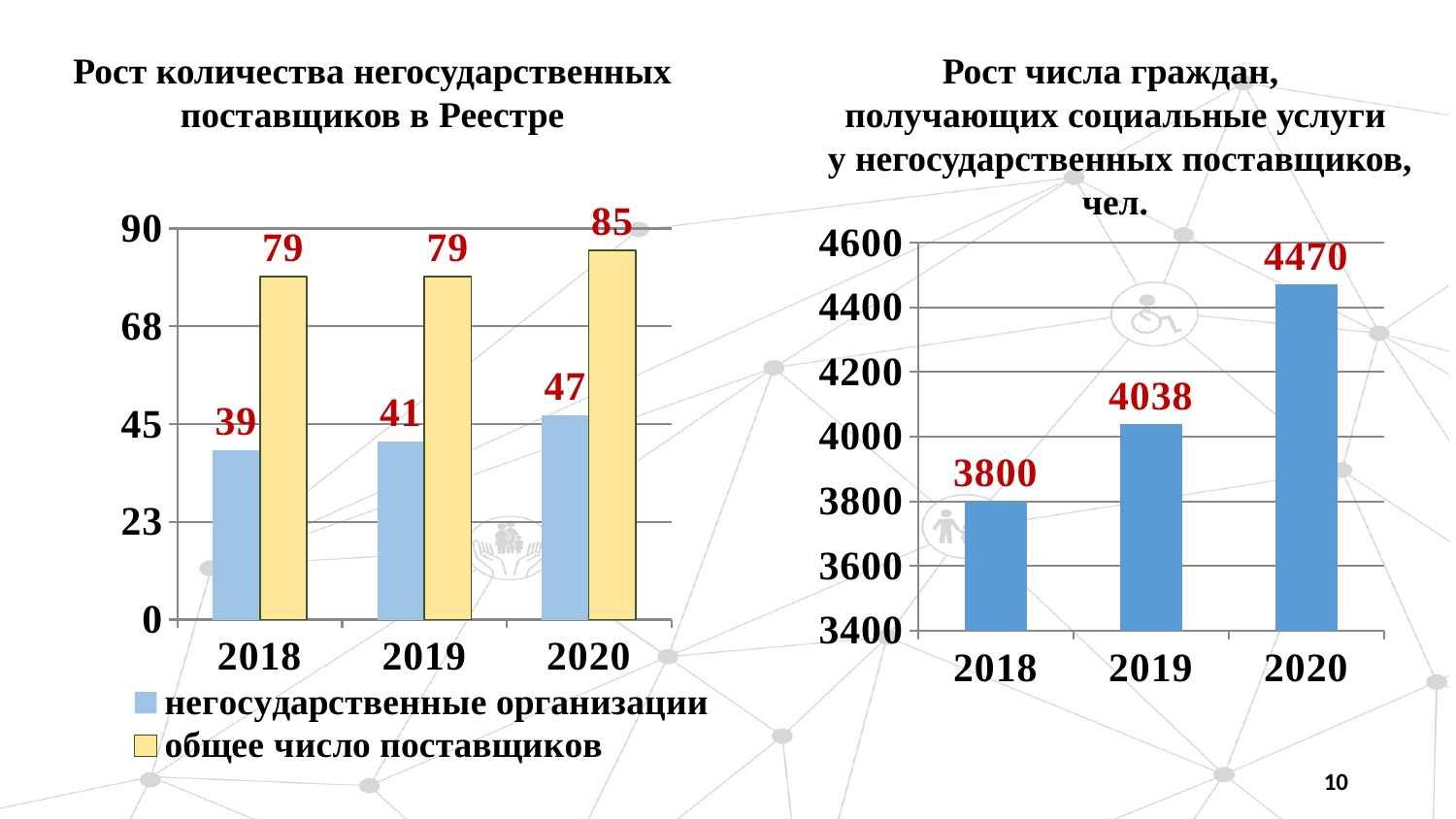
What kind of chart is the right chart? bar chart In the left chart (Рост количества негосударственных поставщиков в Реестре), what is the value for негосударственные организации in 2020? 47 In the left chart, what is the difference between общее число поставщиков and негосударственные организации in 2019? 38 In the right chart, which year has the lowest value? 2018 In the left chart, which colour represents общее число поставщиков? yellow In the right chart, how many years are shown on the x axis? 3 In the right chart (Рост числа граждан, получающих социальные услуги у негосударственных поставщиков), what is the value for 2019? 4038 In the right chart, what is the difference between the values for 2020 and 2018? 670 In the left chart, do the values for негосударственные организации rise or fall from 2018 to 2020? rise In the left chart, what is the value for общее число поставщиков in 2018? 79 In the left chart, how many series does the legend list? 2 In the left chart, which year has the highest value for негосударственные организации? 2020